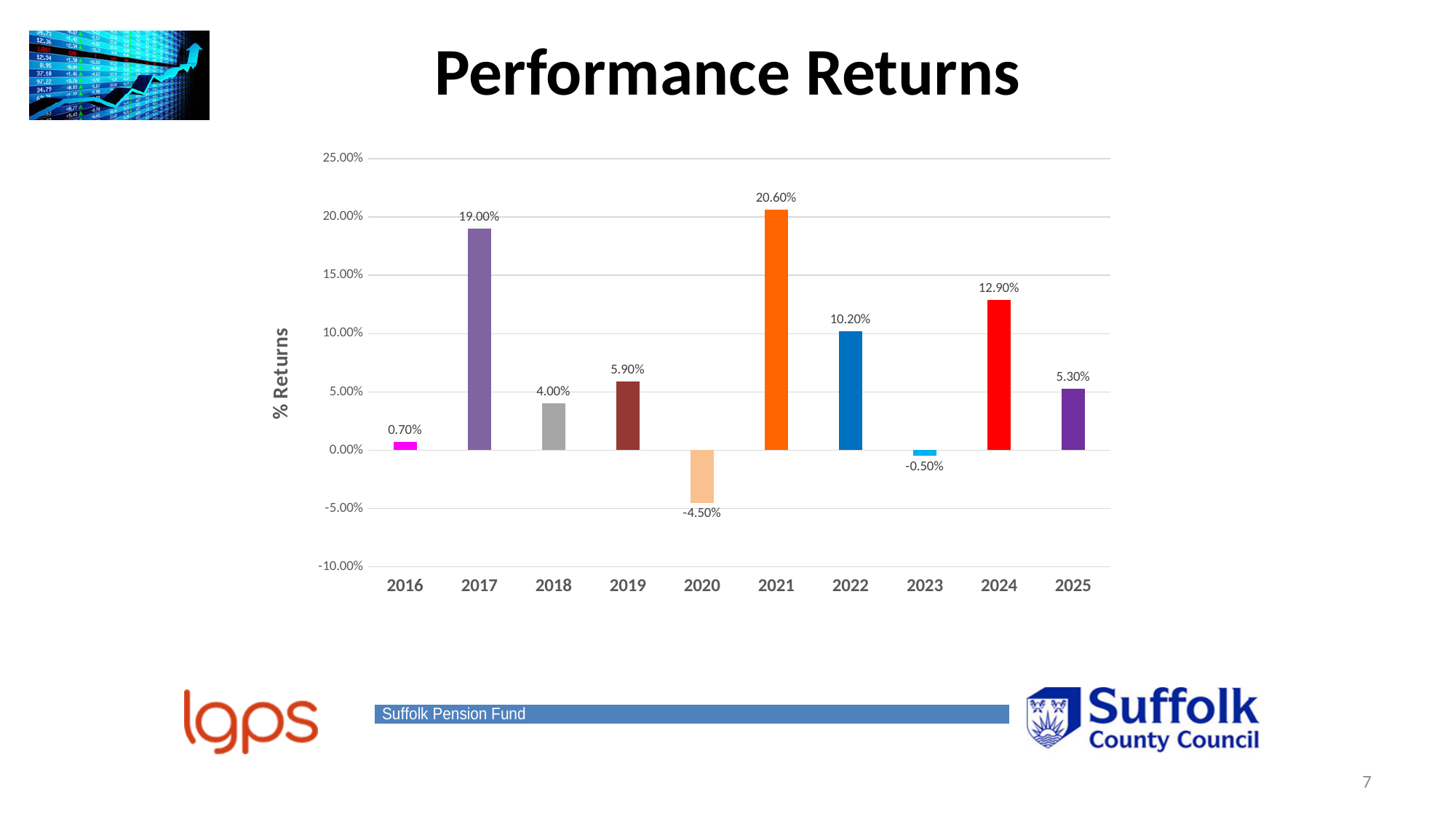
How many years are shown on the x axis? 10 Which year has the lowest % return? 2020 What is the difference between the % returns for 2024 and 2022? 2.70% Is the value for 2024 greater or less than 10.00%? greater What is the difference between the % returns for 2021 and 2017? 1.60% What kind of chart is shown on the slide? Bar chart What is the title of the chart's vertical axis? % Returns What is the % return for 2020? -4.50% Which year has the larger % return, 2019 or 2018? 2019 What is the % return for 2021? 20.60% Which year has the highest % return? 2021 What is the % return for 2025? 5.30%